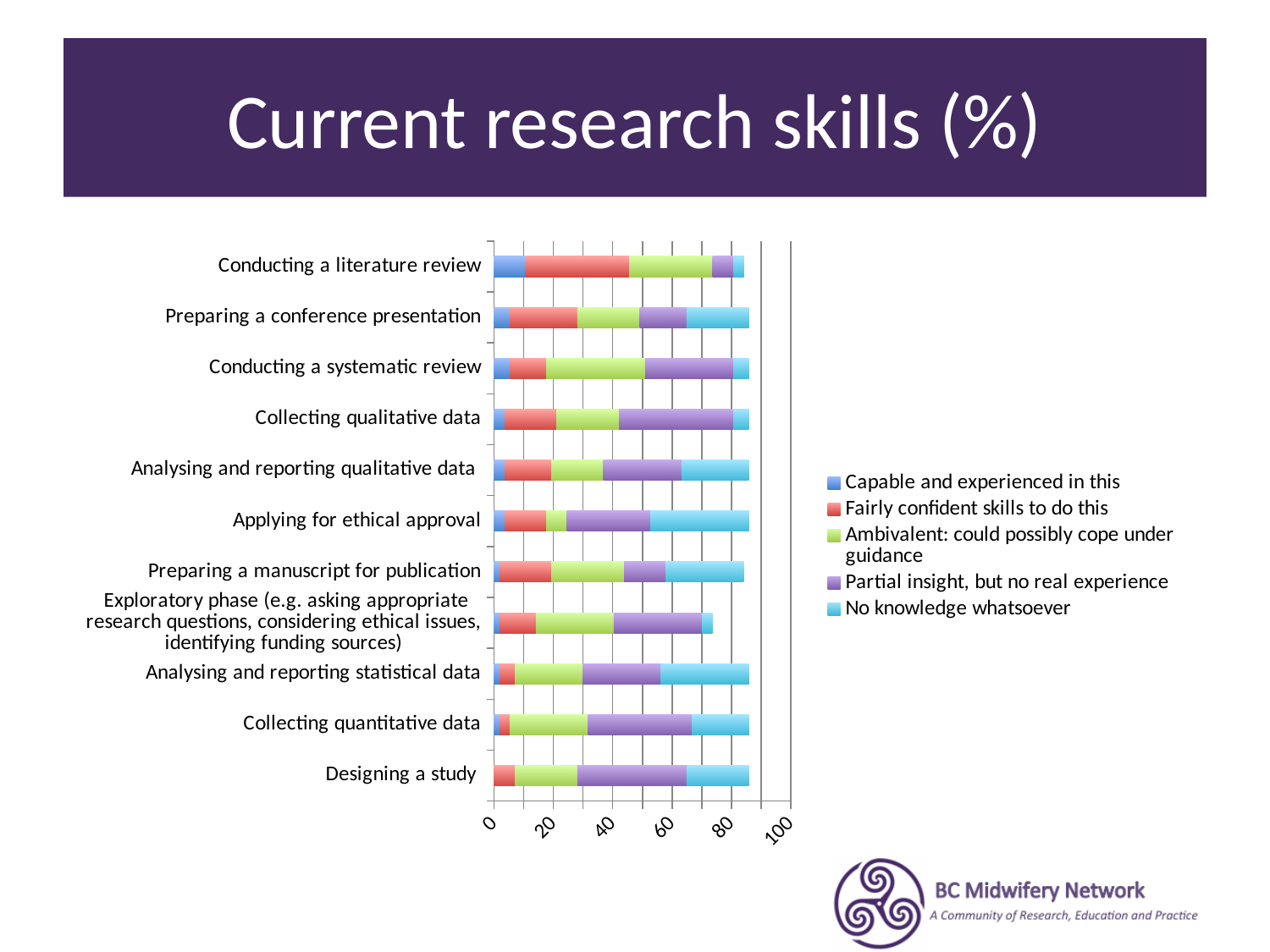
Is the 'Capable and experienced in this' segment larger for 'Conducting a literature review' or for 'Designing a study'? Conducting a literature review Is the 'Ambivalent: could possibly cope under guidance' segment larger for 'Conducting a systematic review' or for 'Applying for ethical approval'? Conducting a systematic review Which colour represents 'No knowledge whatsoever' in the legend? Light blue What is the title of the chart? Current research skills (%) Is the total bar length for 'Designing a study' greater or less than 80? greater Which category has the largest 'Fairly confident skills to do this' segment? Conducting a literature review How many research skill categories are listed on the chart? 11 How many series does the legend list? 5 What kind of chart is shown on the slide? Stacked bar chart Which category has the shortest total bar? Exploratory phase (e.g. asking appropriate research questions, considering ethical issues, identifying funding sources) Which category has the largest 'Capable and experienced in this' segment? Conducting a literature review Is the total bar length for 'Exploratory phase' greater or less than 80? less